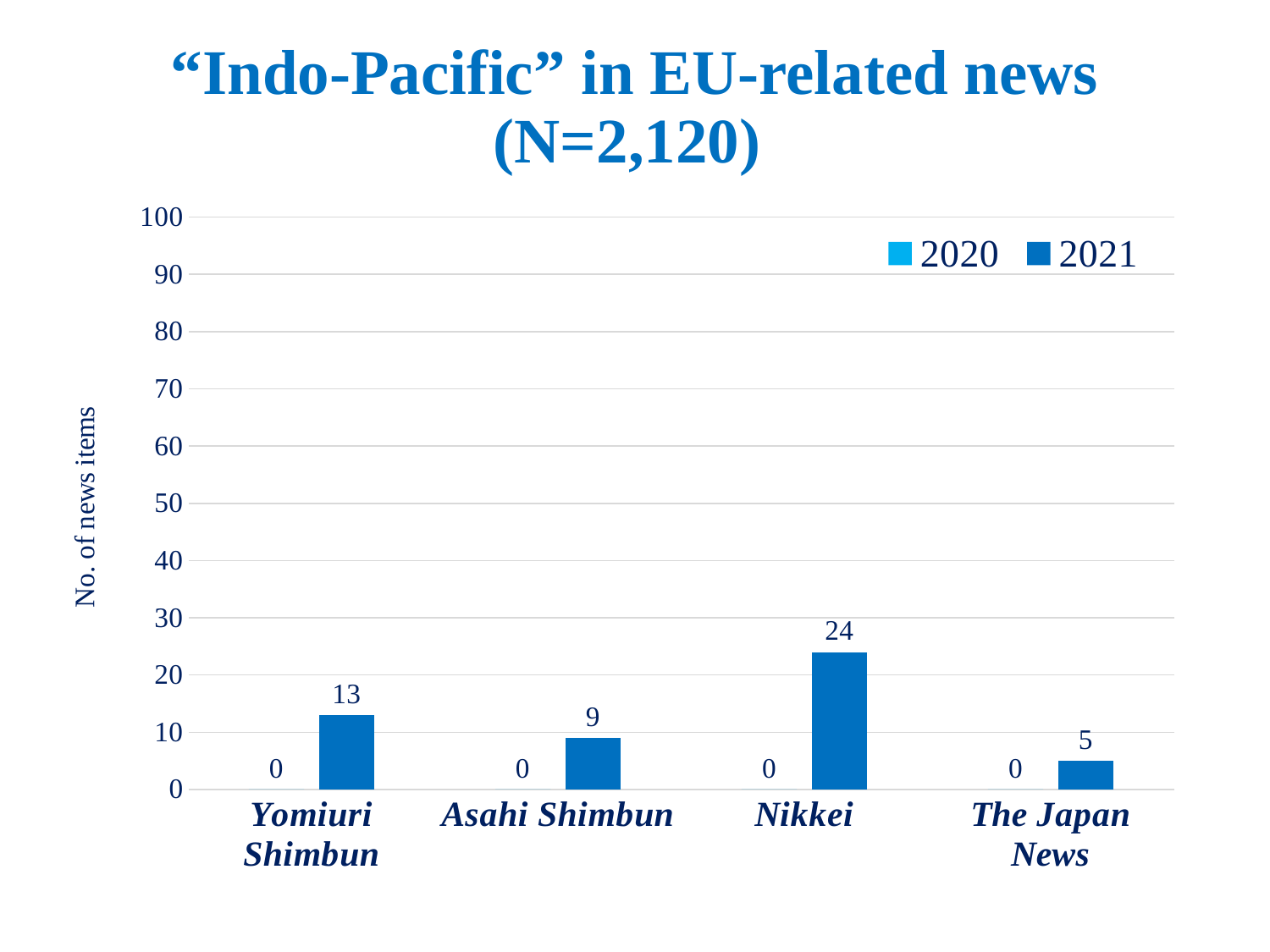
Which newspaper has the lowest 2021 value? The Japan News What is the 2020 value for Asahi Shimbun? 0 What is the 2021 value for Nikkei? 24 How many newspapers are shown on the x axis? 4 What is the 2021 value for The Japan News? 5 Which is larger, the 2021 value for Yomiuri Shimbun or for Asahi Shimbun? Yomiuri Shimbun What is the 2021 value for Yomiuri Shimbun? 13 Which newspaper has the highest 2021 value? Nikkei What is the difference between the 2021 values for Nikkei and Asahi Shimbun? 15 What kind of chart is shown on the slide? Bar chart What is the label of the vertical axis? No. of news items How many series does the legend list? 2